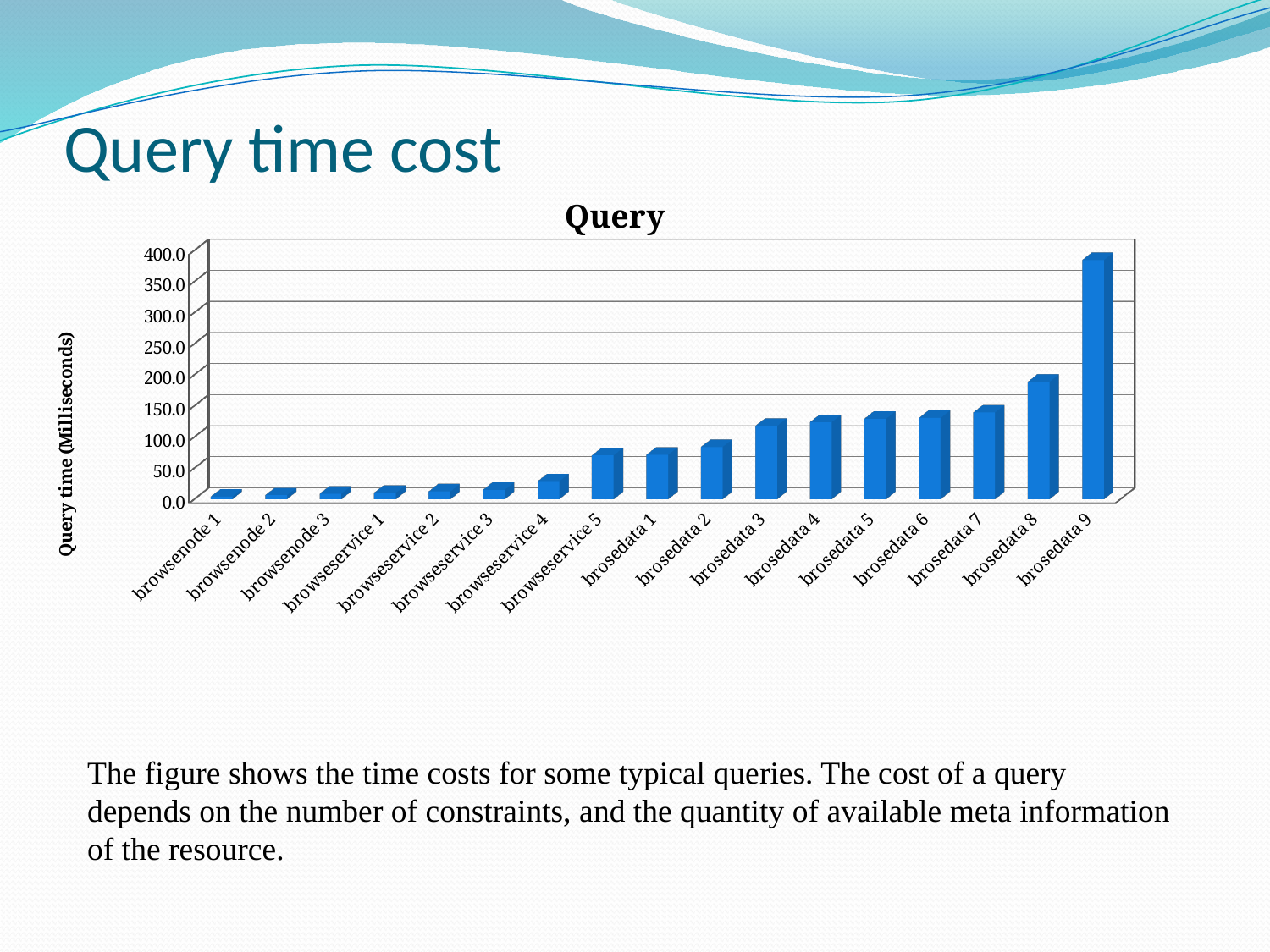
What is the label of the vertical axis? Query time (Milliseconds) Which has a larger query time, brosedata 9 or brosedata 8? brosedata 9 What kind of chart is shown on the slide? bar chart Do the query times generally rise or fall from left to right along the x axis? rise Which category has the lowest query time? browsenode 1 Which category has the highest query time? brosedata 9 How many categories are plotted along the x axis? 17 Is the value for brosedata 9 greater or less than 350.0? greater Is the value for brosedata 2 greater or less than 100.0? less What is the title of the chart? Query Is the value for brosedata 8 greater or less than 150.0? greater